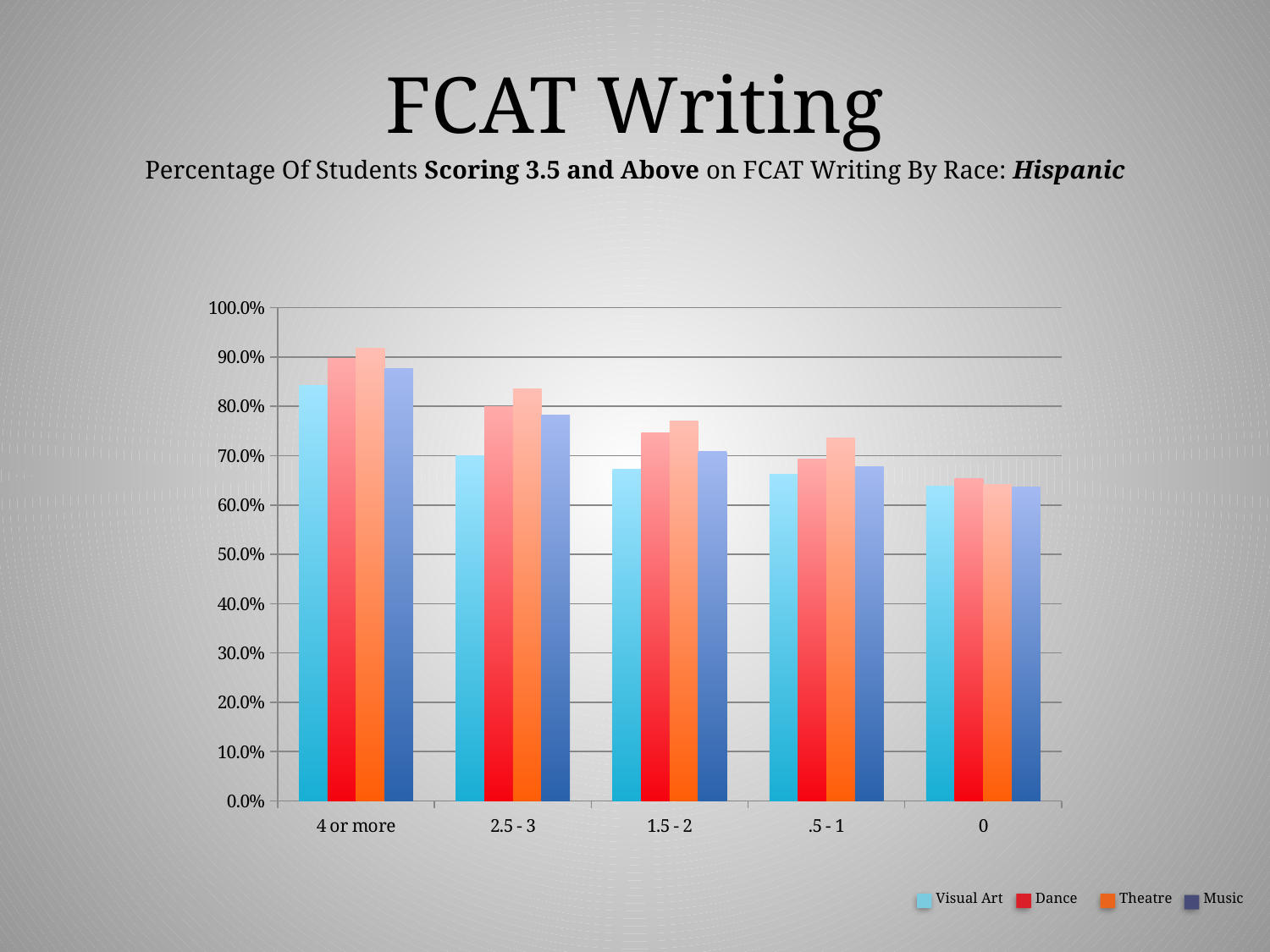
How many series does the legend list? 4 Which series has the highest value in the "4 or more" category? Theatre How many categories are shown along the x axis? 5 Is the value for Music in the ".5 - 1" category greater or less than 70.0%? less Is the value for Visual Art in the "1.5 - 2" category greater or less than 70.0%? less In the "1.5 - 2" category, which is larger: Dance or Music? Dance Which series has the lowest value in the "2.5 - 3" category? Visual Art In the "2.5 - 3" category, which is larger: Theatre or Visual Art? Theatre What are the four series named in the legend? Visual Art, Dance, Theatre, Music Is the value for Visual Art in the "4 or more" category greater or less than 80.0%? greater Do the Theatre values rise or fall moving from "4 or more" to "0" along the x axis? fall What kind of chart is shown on the slide? bar chart